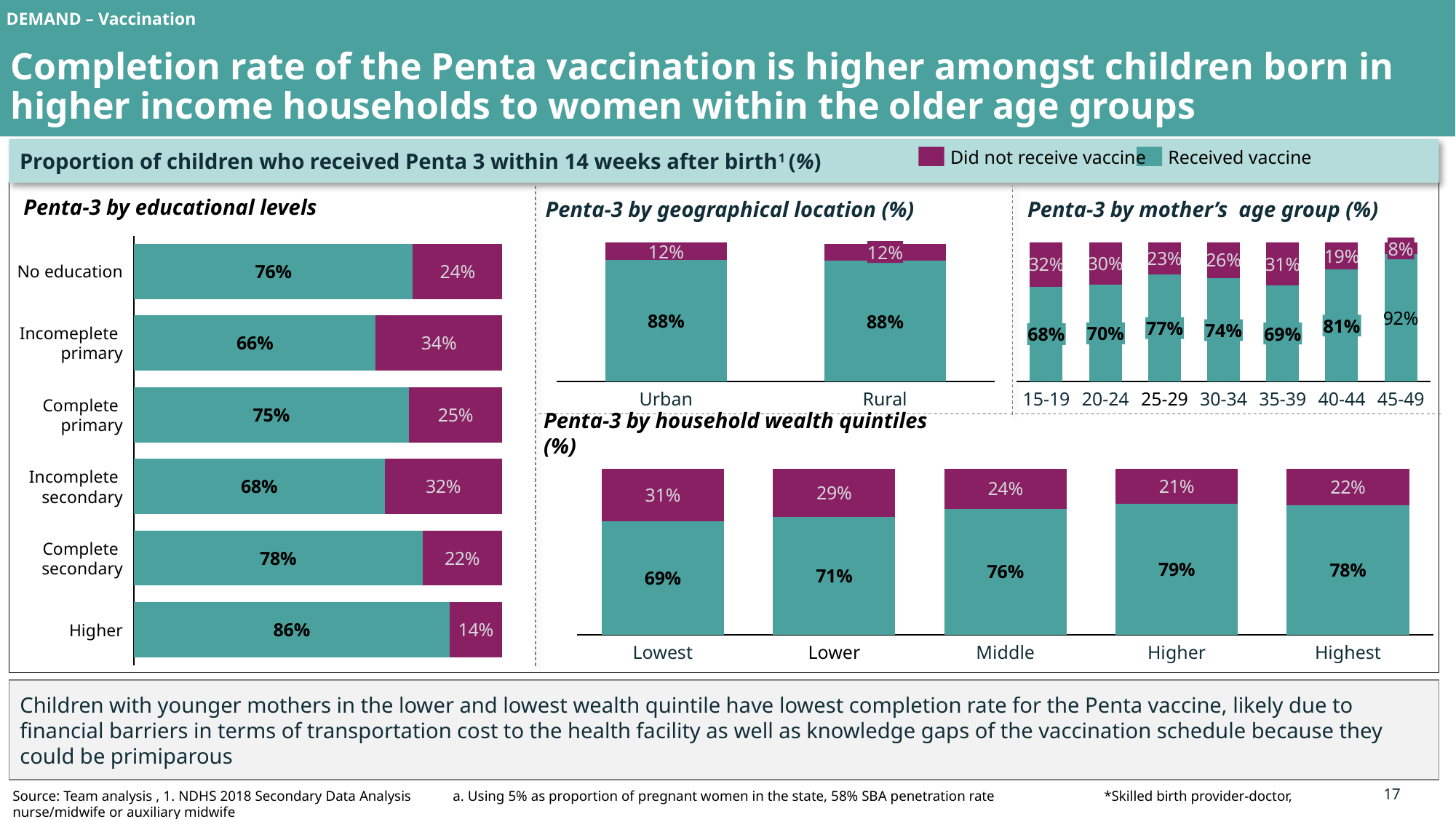
In the 'Penta-3 by educational levels' chart, how many educational level categories are shown? 6 In the 'Penta-3 by geographical location' chart, what is the 'Received vaccine' value for Rural? 88% In the 'Penta-3 by geographical location' chart, what is the difference between the Urban and Rural 'Received vaccine' values? 0 percentage points In the 'Penta-3 by household wealth quintiles' chart, what is the difference in 'Received vaccine' share between the Highest and Lowest quintiles? 9 percentage points In the 'Penta-3 by mother's age group' chart, which age group has the highest 'Received vaccine' share? 45-49 How many series does the legend list? 2 In the 'Penta-3 by mother's age group' chart, how many age groups are shown? 7 In the 'Penta-3 by educational levels' chart, what percentage of children of mothers with higher education received the vaccine? 86% In the 'Penta-3 by educational levels' chart, what is the 'Did not receive vaccine' value for Incomplete secondary? 32% In the 'Penta-3 by household wealth quintiles' chart, which quintile has the highest 'Received vaccine' share? Higher In the 'Penta-3 by mother's age group' chart, what is the 'Did not receive vaccine' value for the 15-19 age group? 32% In the 'Penta-3 by educational levels' chart, which educational level has the lowest 'Received vaccine' share? Incomplete primary